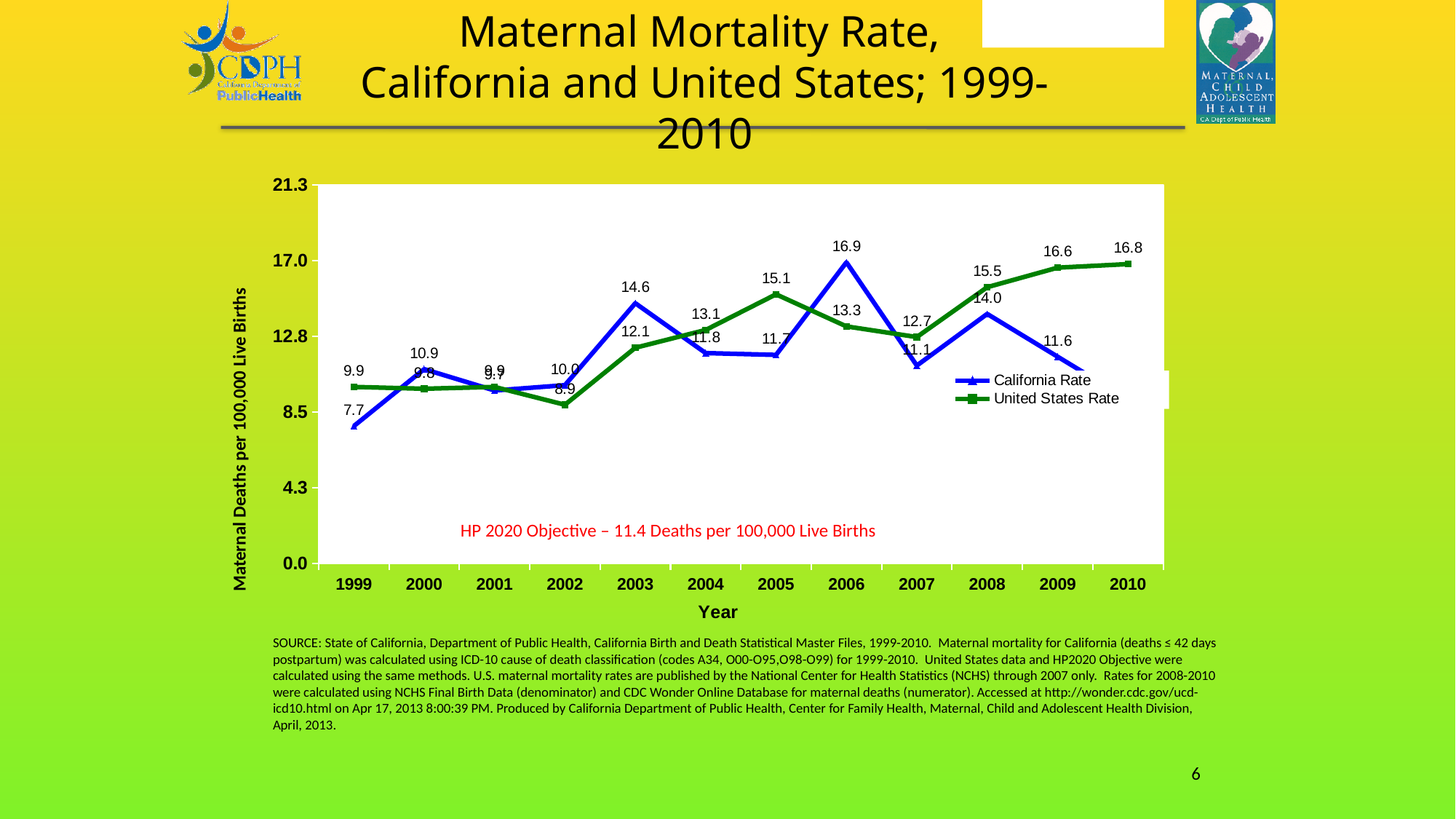
In which year was the California Rate highest? 2006 In which year was the California Rate lowest? 1999 How many series does the legend list? 2 How many years are plotted on the x axis? 12 In 2005, which was higher, the California Rate or the United States Rate? United States Rate What was the California Rate in 2006? 16.9 What was the United States Rate in 2010? 16.8 What was the United States Rate in 2002? 8.9 What was the California Rate in 1999? 7.7 What kind of chart is shown on the slide? line chart What is the HP 2020 Objective stated on the chart? 11.4 Deaths per 100,000 Live Births What is the difference between the California Rate and the United States Rate in 2006? 3.6